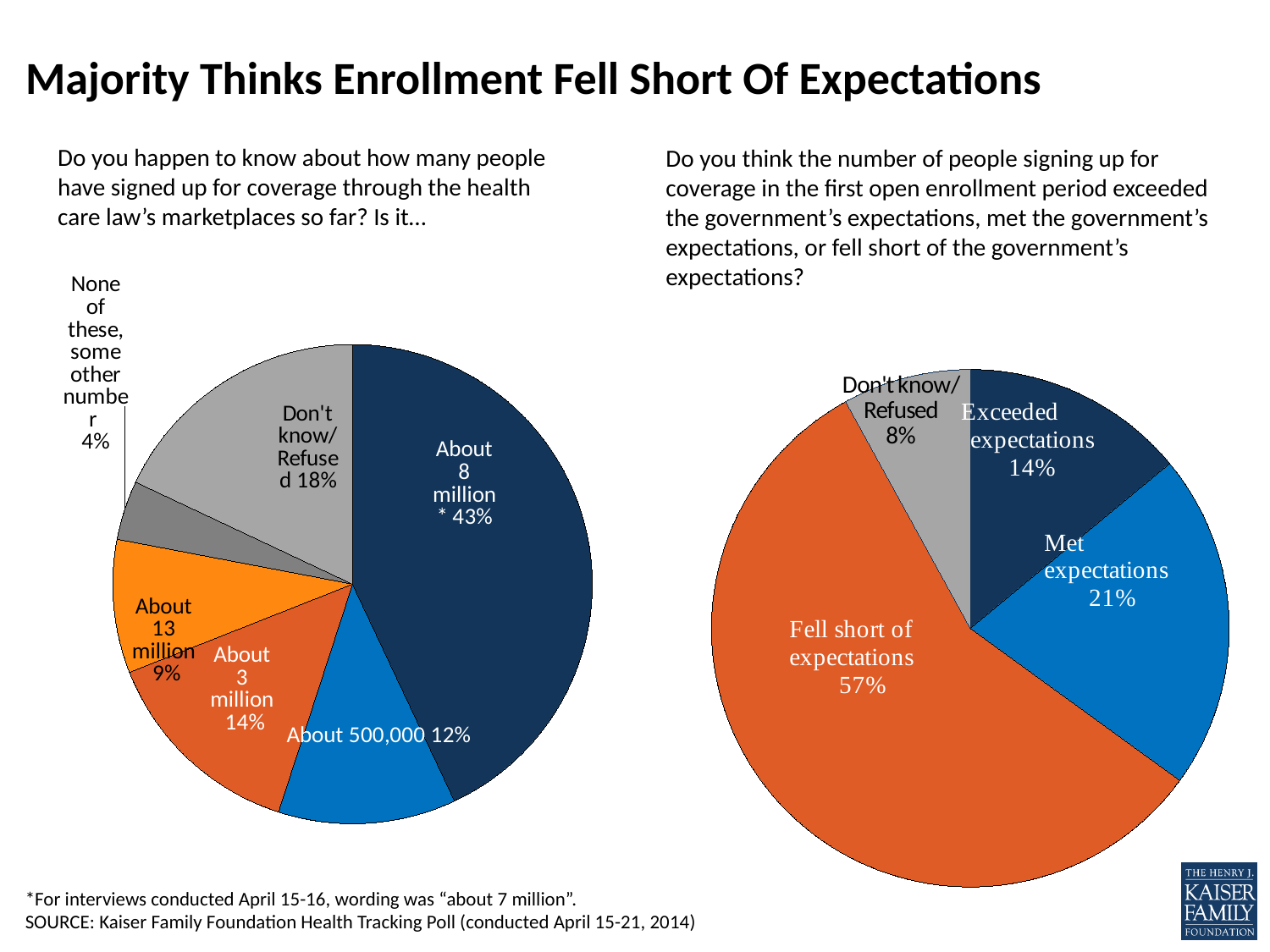
In the left pie chart, what is the difference between the share for 'About 8 million' and the share for 'About 3 million'? 29 percentage points In the right pie chart, what share of respondents said enrollment exceeded expectations? 14% In the right pie chart, which is larger: 'Met expectations' or 'Exceeded expectations'? Met expectations In the left pie chart, how many slices are there? 6 In the right pie chart, what is the difference between 'Fell short of expectations' and 'Met expectations'? 36 percentage points In the right pie chart, what share of respondents said enrollment fell short of expectations? 57% What is the title of the slide? Majority Thinks Enrollment Fell Short Of Expectations In the left pie chart, which response has the smallest share? None of these, some other number In the left pie chart, what share of respondents said about 8 million people have signed up? 43% In the left pie chart, which response has the largest share? About 8 million In the left pie chart, what share of respondents answered 'Don't know/Refused'? 18% What type of chart is used on the right side of the slide? Pie chart